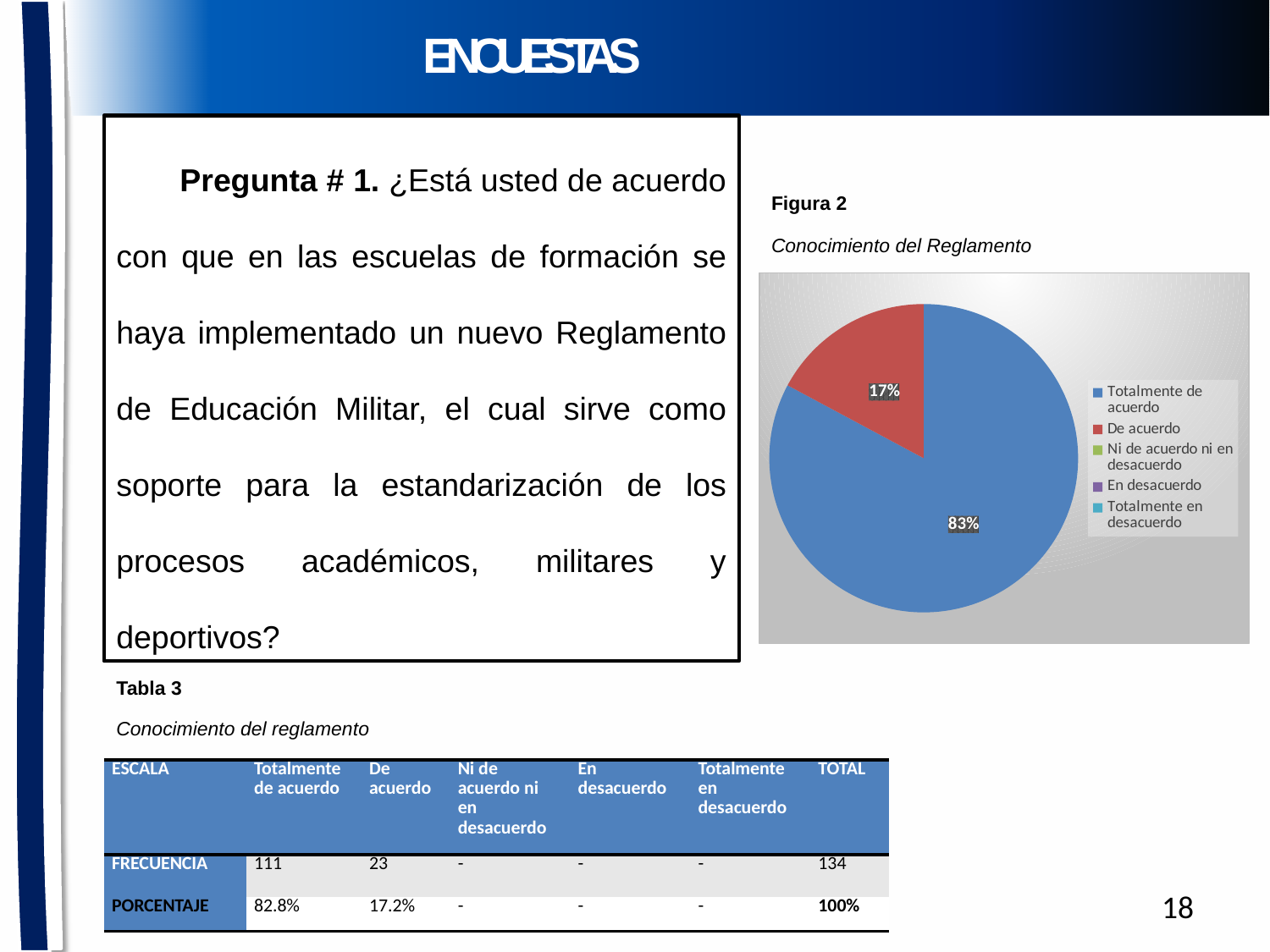
What is the title of the pie chart (Figura 2)? Conocimiento del Reglamento What is the difference in percentage points between the 'Totalmente de acuerdo' and 'De acuerdo' slices in the pie chart? 66 How many slices with a printed percentage label are visible in the pie chart? 2 In the pie chart, what share is labelled for the 'Totalmente de acuerdo' slice? 83% Which category has the largest slice in the pie chart? Totalmente de acuerdo How many entries does the legend of the pie chart list? 5 In the pie chart, what share is labelled for the 'De acuerdo' slice? 17% What colour is the 'Totalmente de acuerdo' slice in the pie chart? blue Of the slices visible in the pie chart, which is the smallest? De acuerdo Is the share of the 'De acuerdo' slice in the pie chart greater or less than 50%? less What kind of chart is shown under Figura 2? pie chart In the pie chart, which slice is larger: 'Totalmente de acuerdo' or 'De acuerdo'? Totalmente de acuerdo